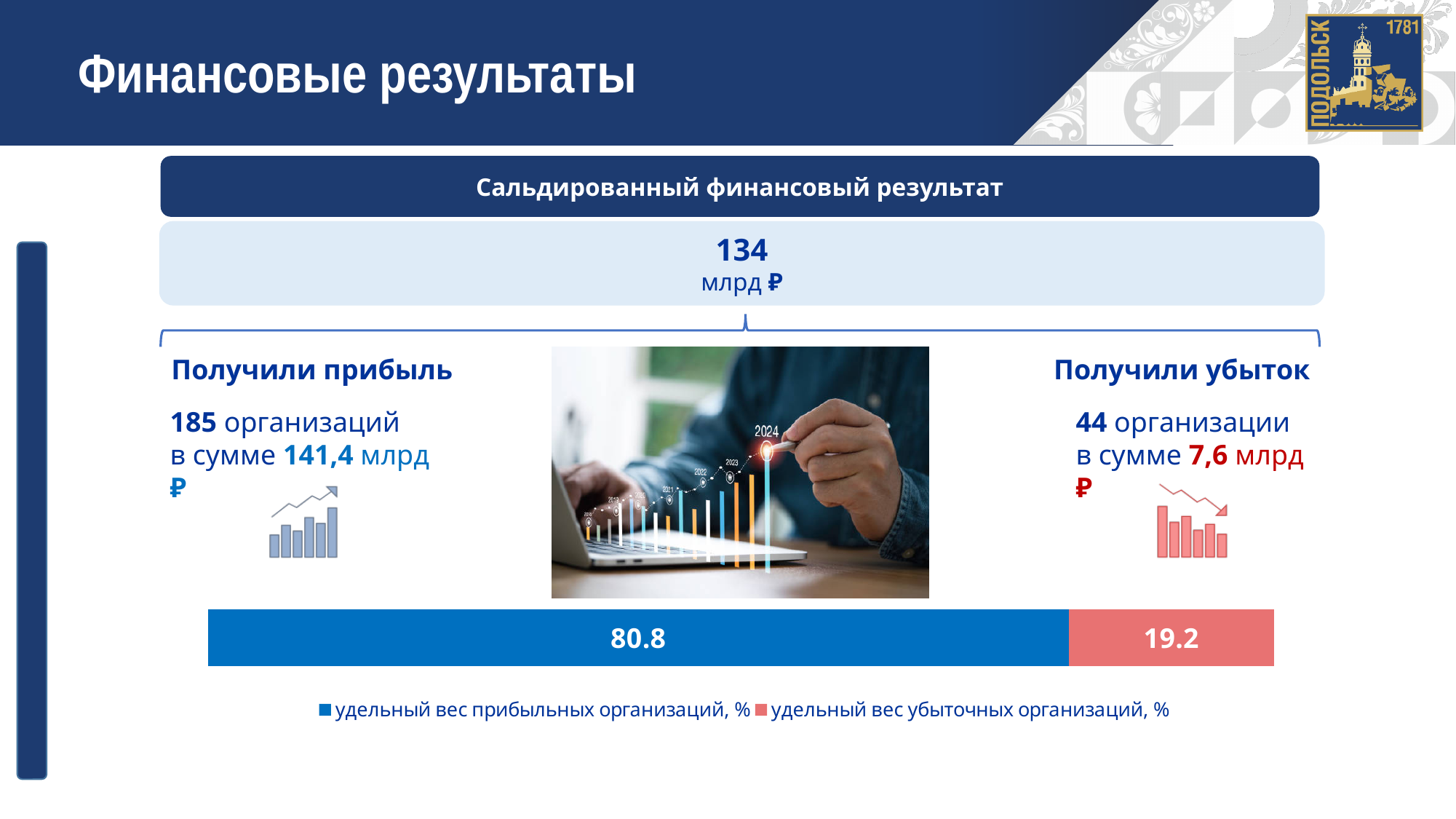
Which series has the larger value in the bar chart, "удельный вес прибыльных организаций, %" or "удельный вес убыточных организаций, %"? удельный вес прибыльных организаций, % How many bars are plotted in the chart at the bottom of the slide? 1 What is the difference between the two values shown in the bar chart (80.8 and 19.2)? 61.6 Which series has the smallest value in the bar chart? удельный вес убыточных организаций, % What is the value shown for the series "удельный вес прибыльных организаций, %" in the bar chart? 80.8 What is the value shown for the series "удельный вес убыточных организаций, %" in the bar chart? 19.2 Which series has the largest value in the bar chart? удельный вес прибыльных организаций, % What is the total of the two segments in the stacked bar? 100 How many series does the legend of the bar chart list? 2 What colour is the segment for "удельный вес прибыльных организаций, %" in the bar chart? Blue What kind of chart is shown at the bottom of the slide? Stacked bar chart What colour is the segment for "удельный вес убыточных организаций, %" in the bar chart? Red (salmon)